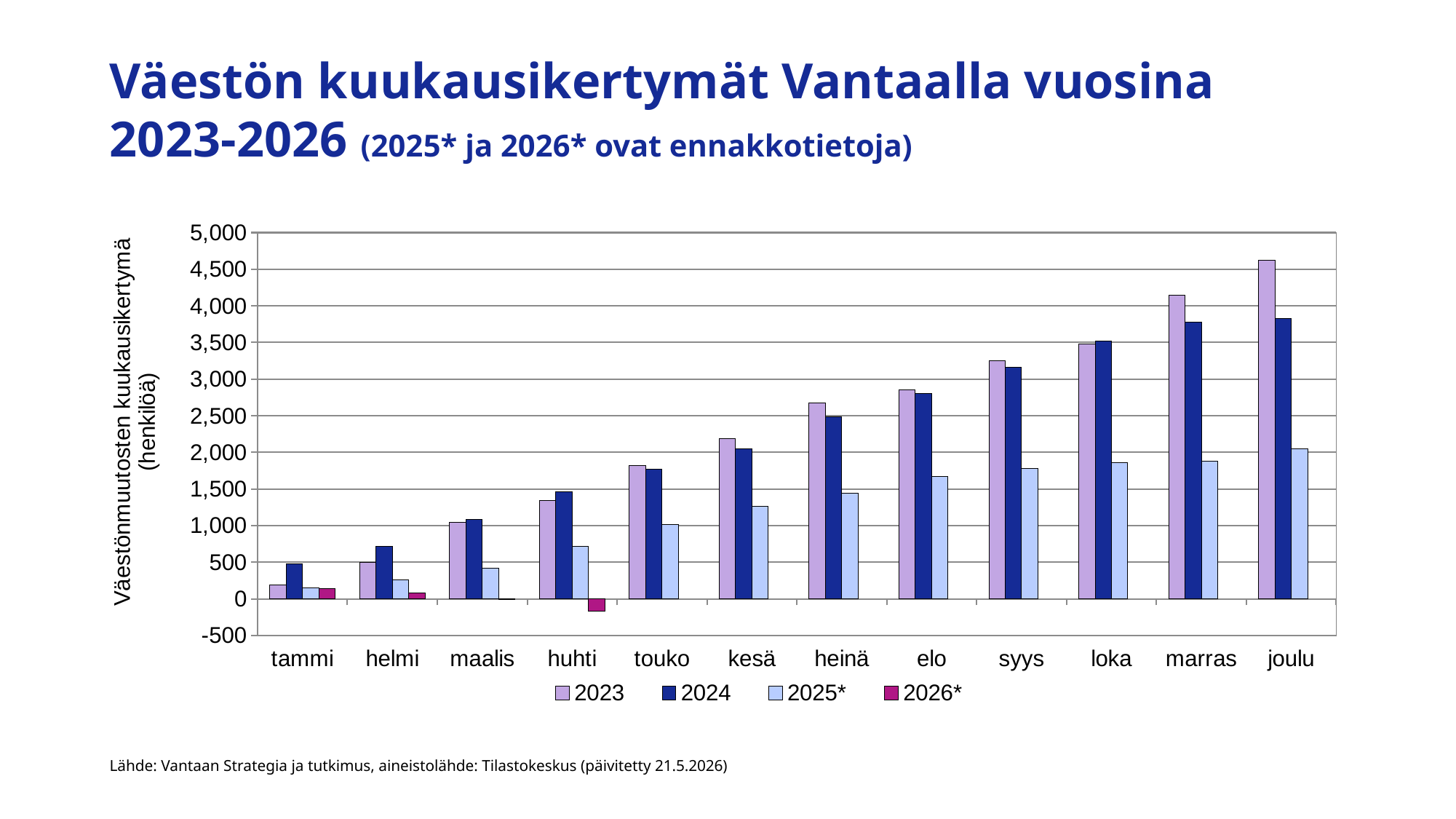
Do the 2023 values rise or fall from tammi to joulu? rise How many series does the legend list? 4 Is the 2024 value for joulu greater or less than 4,000? less What is the title of the y axis? Väestönmuutosten kuukausikertymä (henkilöä) In which month is the 2023 value highest? joulu In which month is the 2026* value lowest? huhti What kind of chart is shown on the slide? bar chart For tammi, which is larger: the 2023 value or the 2024 value? 2024 How many months are shown on the x axis? 12 Is the 2025* value for loka greater or less than 2,000? less Is the 2023 value for joulu greater or less than 4,000? greater For marras, which is larger: the 2023 value or the 2024 value? 2023